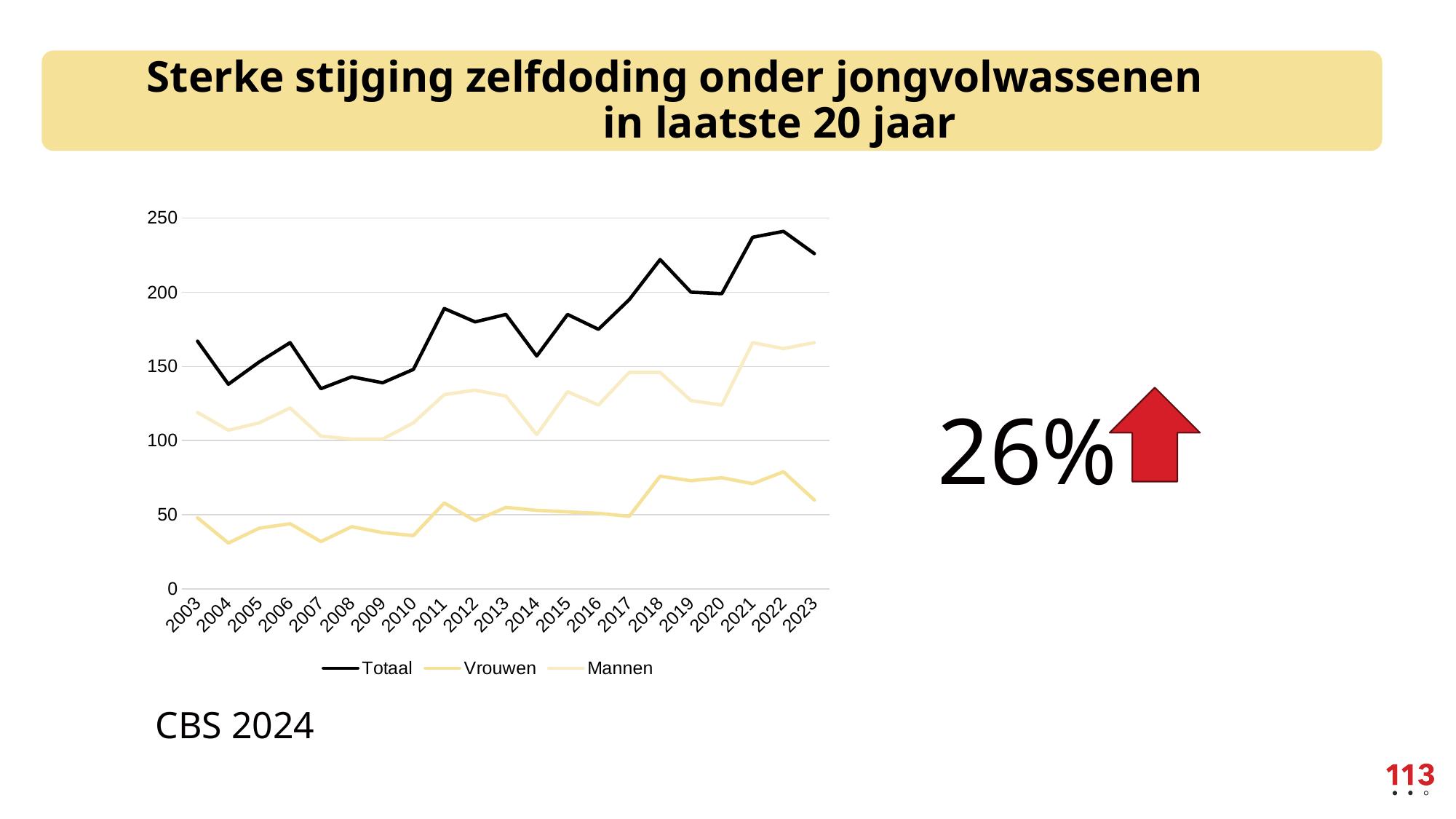
What source is cited below the chart? CBS 2024 How many series does the chart legend list? 3 In 2023, which series has the larger value, Mannen or Vrouwen? Mannen Does the Totaal series generally rise or fall from 2003 to 2023? rise For the Totaal series, which year has the larger value, 2018 or 2019? 2018 Is the Totaal value for 2022 greater or less than 200? greater What kind of chart is shown on the slide? line chart Is the Totaal value for 2007 greater or less than 150? less How many years are plotted along the x axis of the chart? 21 Which series are listed in the chart legend? Totaal, Vrouwen, Mannen Is the Mannen value for 2021 greater or less than 150? greater